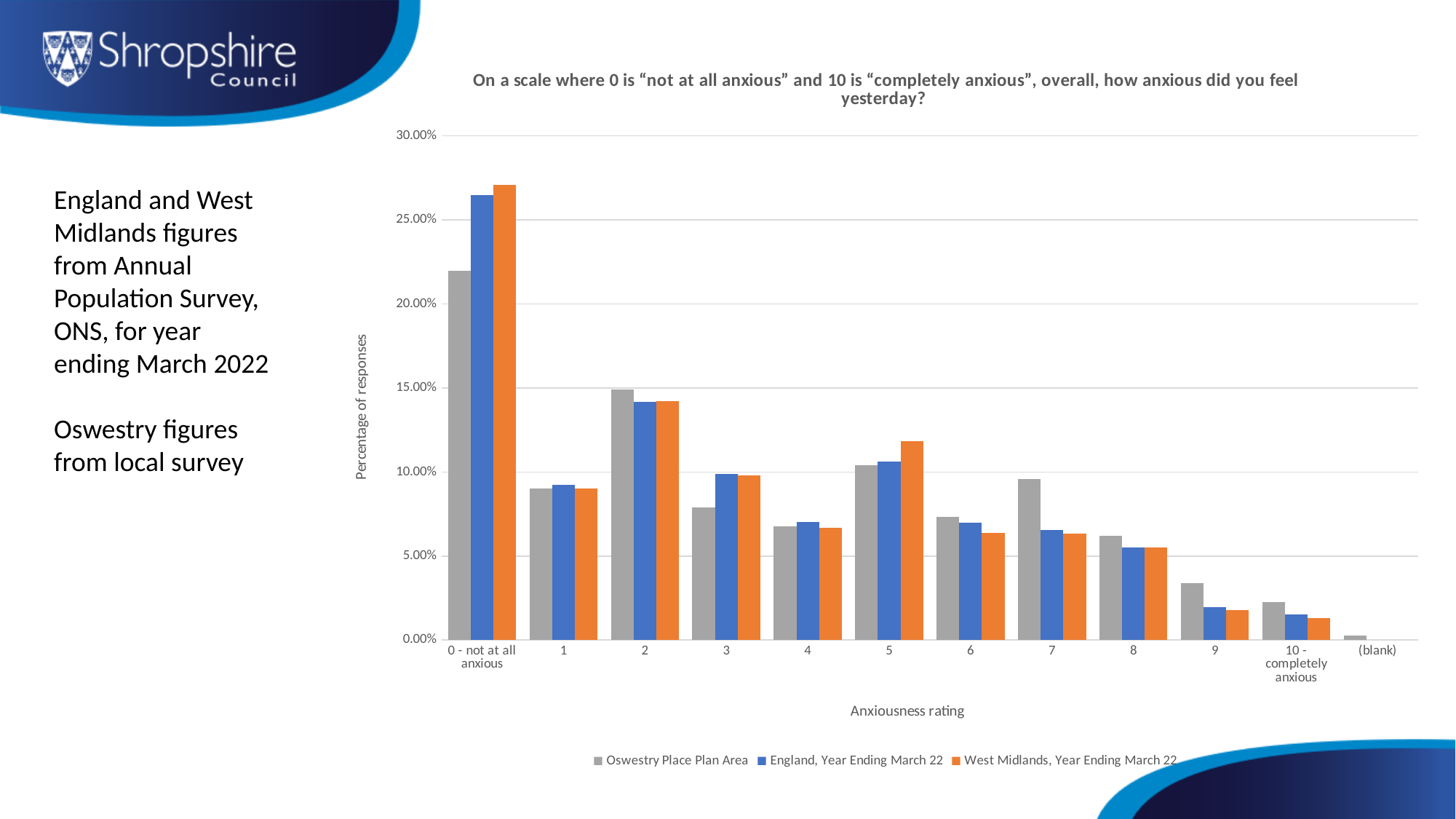
How many series does the legend list? 3 What kind of chart is shown on the slide? Bar chart At rating 7, which series has the larger value: Oswestry Place Plan Area or England, Year Ending March 22? Oswestry Place Plan Area Do the England, Year Ending March 22 values rise or fall from rating 5 to '10 - completely anxious'? Fall Is the West Midlands, Year Ending March 22 value for rating 5 greater or less than 10.00%? greater Which anxiousness rating has the highest value for the West Midlands, Year Ending March 22 series? 0 - not at all anxious Which anxiousness rating has the highest value for the Oswestry Place Plan Area series? 0 - not at all anxious Which series is shown in orange in the legend? West Midlands, Year Ending March 22 Is the England, Year Ending March 22 value for '0 - not at all anxious' greater or less than 25.00%? greater How many categories are shown along the x axis? 12 Is the Oswestry Place Plan Area value for '0 - not at all anxious' greater or less than 20.00%? greater